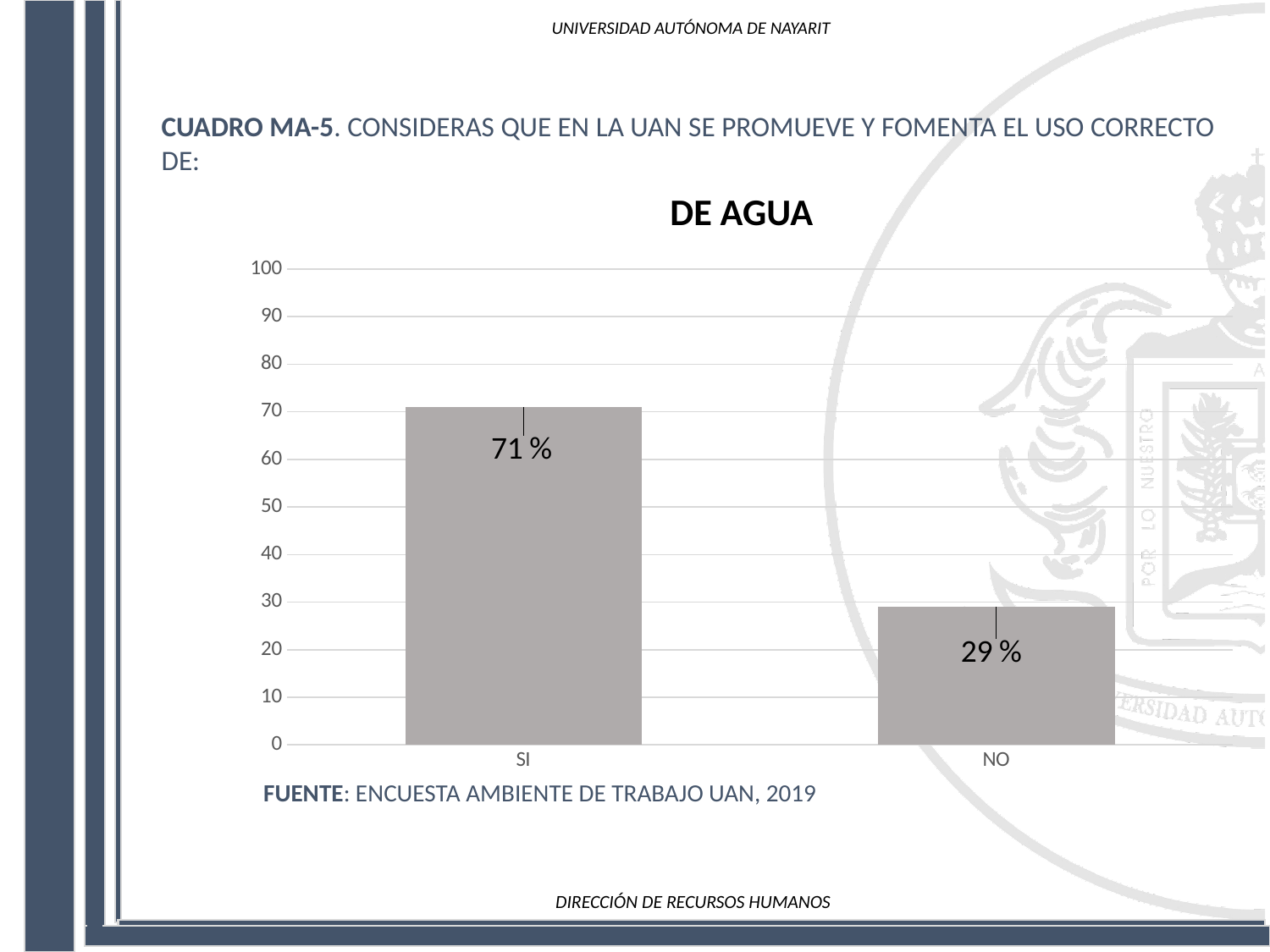
Which category has the lowest value? NO Which is larger, the value for SI or the value for NO? SI What is the value for NO? 29 % What kind of chart is shown? bar chart Which category has the highest value? SI What is the value for SI? 71 % How many categories are shown on the x axis? 2 What is the highest value shown on the y axis? 100 Is the value for SI greater or less than 60? greater What is the difference between the values for SI and NO? 42 % What is the title of the chart? DE AGUA Is the value for NO greater or less than 40? less